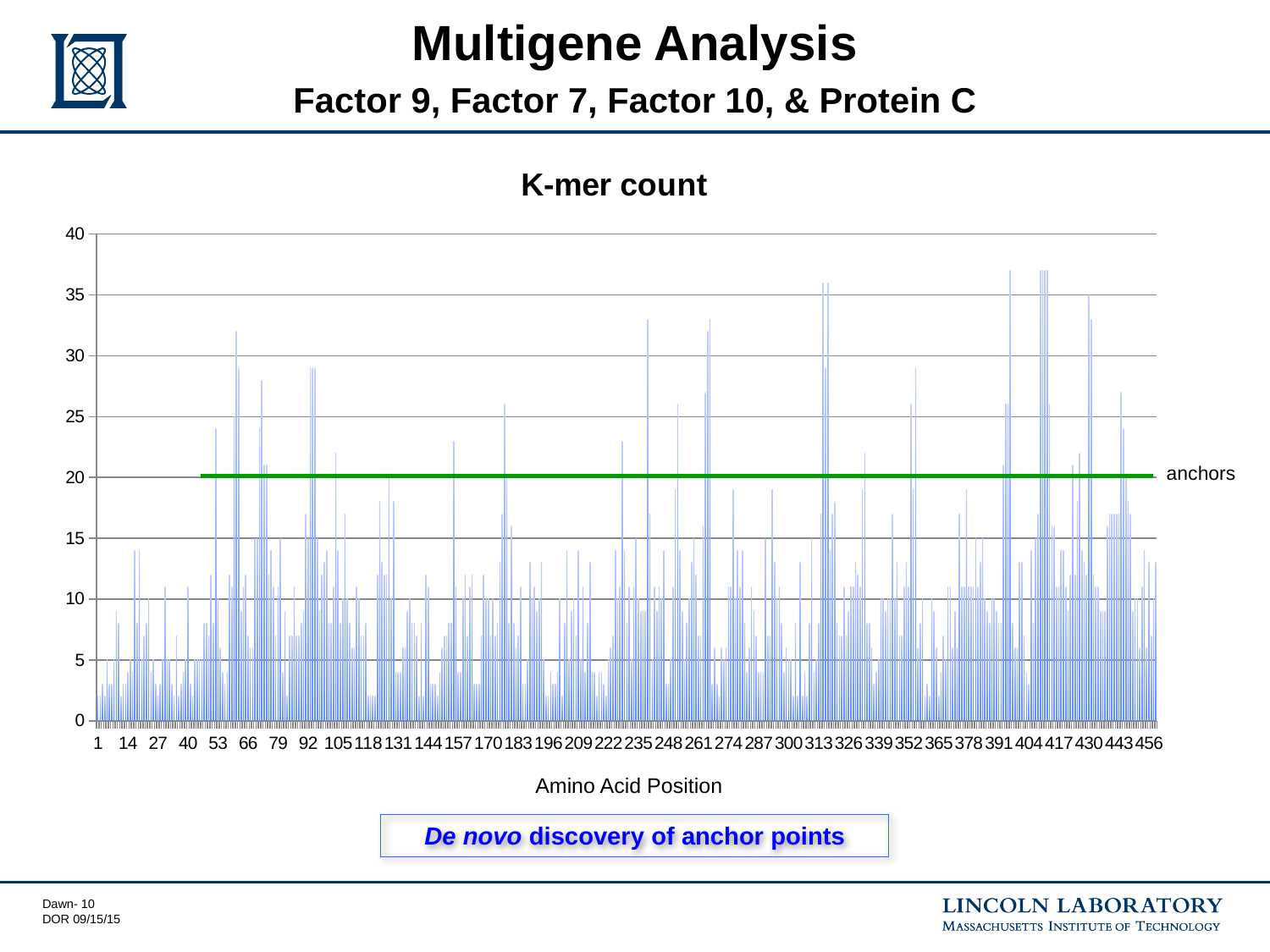
Is the bar at amino acid position 1 greater or less than 10? less At what y-axis value is the green horizontal 'anchors' line drawn? 20 Is the bar at amino acid position 456 greater or less than 20? less What is the label of the x axis of the chart? Amino Acid Position What is the title of the chart? K-mer count What kind of chart is shown on the slide? bar chart Is the tallest bar in the chart greater or less than 35? greater